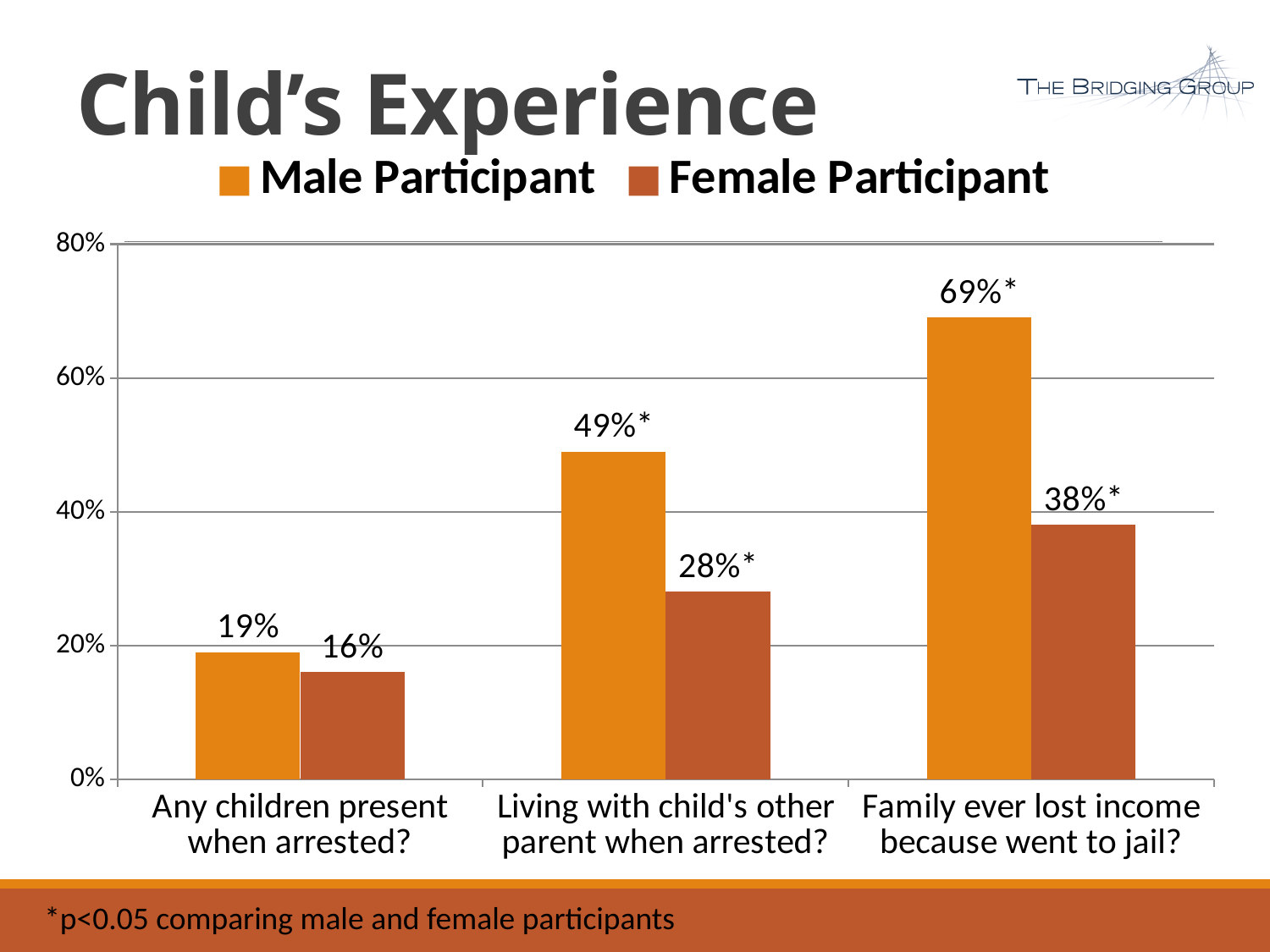
How many categories are shown on the x axis? 3 How many series does the legend list? 2 What is the value for Male Participant in the "Family ever lost income because went to jail?" category? 69%* Is the Female Participant value for "Family ever lost income because went to jail?" greater or less than 40%? less What is the title of the slide containing the chart? Child's Experience Which category has the lowest Female Participant value? Any children present when arrested? Which is larger in the "Living with child's other parent when arrested?" category: Male Participant or Female Participant? Male Participant What is the value for Male Participant in the "Any children present when arrested?" category? 19% Which category has the highest Male Participant value? Family ever lost income because went to jail? What kind of chart is shown on the slide? bar chart What is the difference between the Male Participant and Female Participant values for "Family ever lost income because went to jail?"? 31% What is the value for Female Participant in the "Living with child's other parent when arrested?" category? 28%*